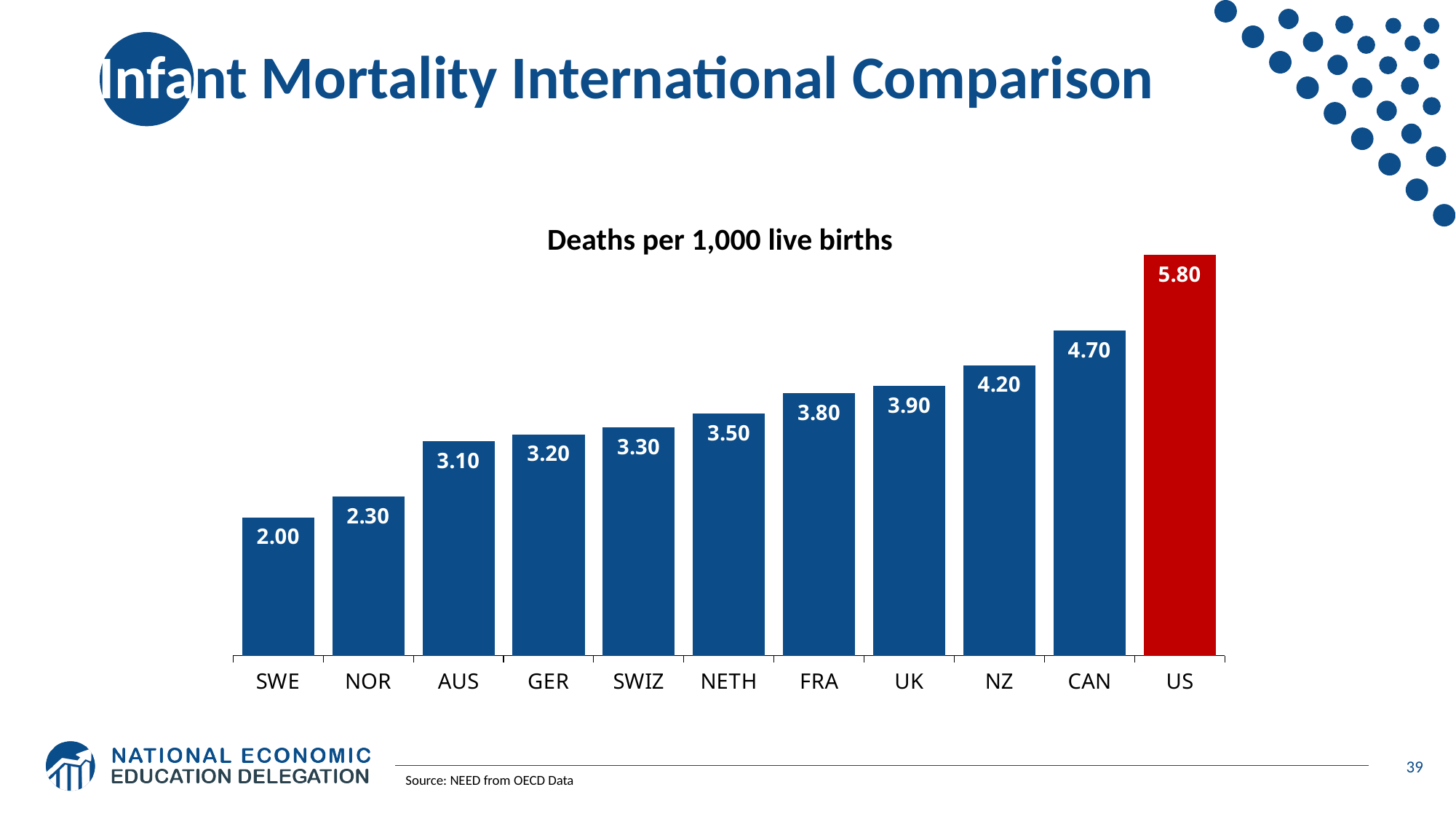
What is the value for NOR in the chart? 2.30 Do the values rise or fall from left to right along the x axis? Rise What is the title of the chart? Deaths per 1,000 live births What is the difference between the values for the US and CAN? 1.10 Which country has the highest infant mortality rate in the chart? US Which country has the lowest infant mortality rate in the chart? SWE Which has a higher value, NZ or FRA? NZ What kind of chart is shown on the slide? Bar chart What is the value for the US in the chart? 5.80 What is the difference between the values for UK and SWE? 1.90 How many countries are shown in the chart? 11 What is the value for GER in the chart? 3.20